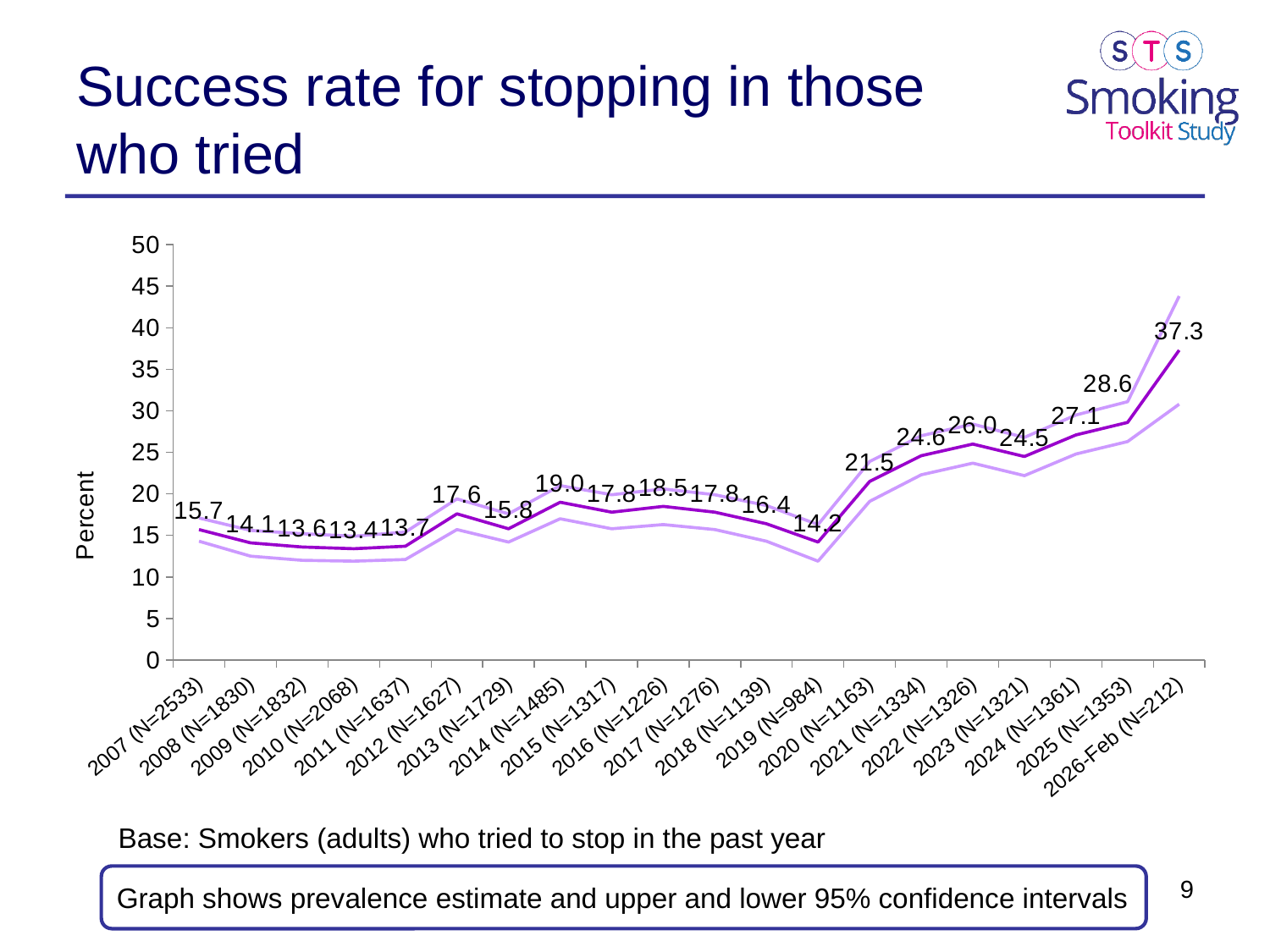
What is the success rate for stopping in 2022 (N=1326)? 26.0 Does the success rate rise or fall from 2020 (N=1163) to 2022 (N=1326)? Rise What is the difference between the success rate in 2026-Feb (N=212) and in 2025 (N=1353)? 8.7 Is the upper confidence interval value for 2026-Feb (N=212) greater or less than 40? greater Which year has a higher success rate, 2014 (N=1485) or 2016 (N=1226)? 2014 (N=1485) Which year has the lowest success rate for stopping? 2010 (N=2068) What kind of chart is shown on the slide? Line chart Which year has the highest success rate for stopping? 2026-Feb (N=212) What is the success rate for stopping in 2019 (N=984)? 14.2 What is the success rate for stopping in 2026-Feb (N=212)? 37.3 What is the difference between the success rate in 2007 (N=2533) and in 2019 (N=984)? 1.5 How many years are plotted on the x axis? 20